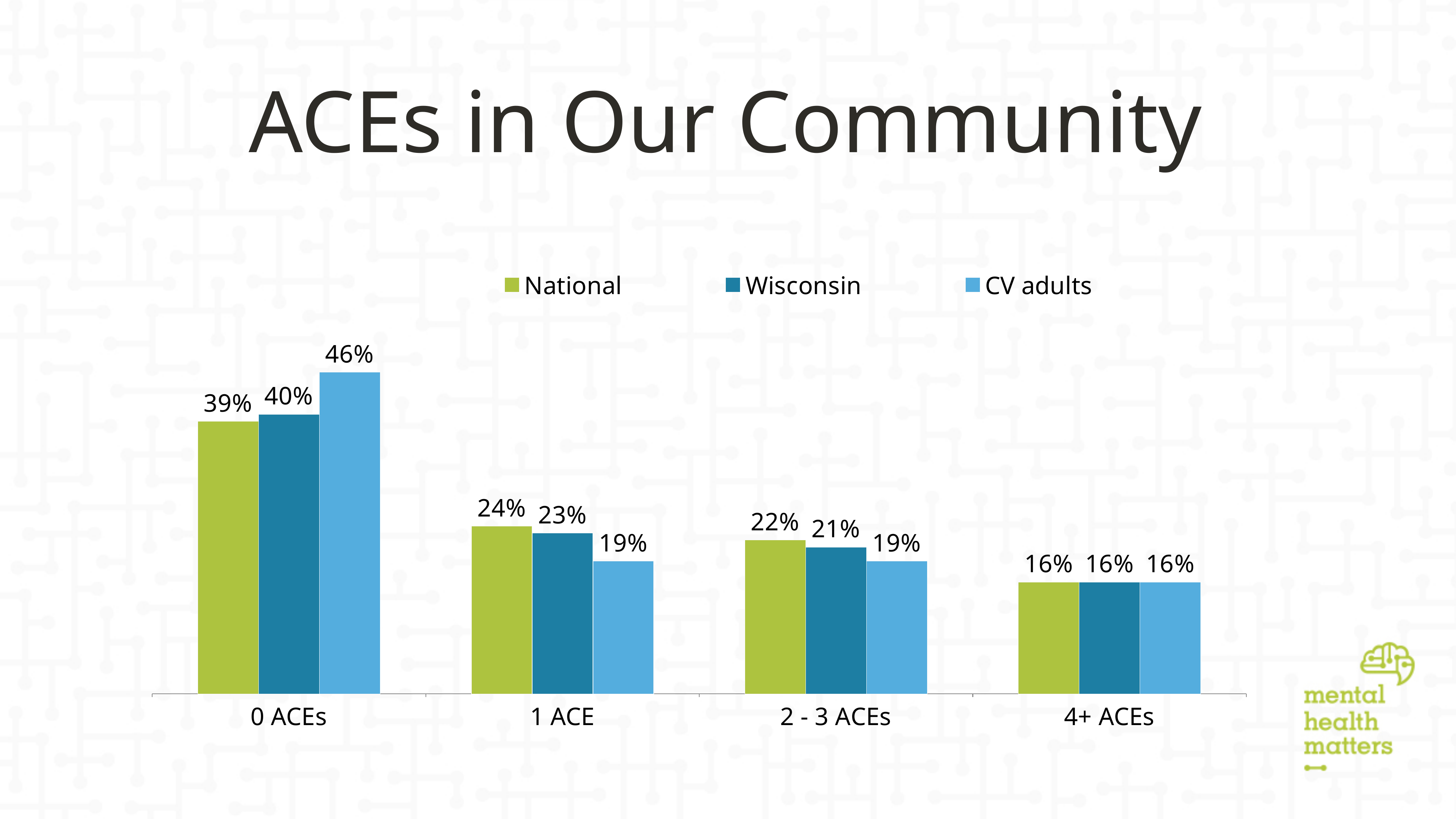
Do the National values rise or fall from 0 ACEs to 4+ ACEs? Fall What is the National value for 1 ACE? 24% How many series does the legend list? 3 What is the CV adults value for 0 ACEs? 46% Which category has the highest CV adults value? 0 ACEs What is the Wisconsin value for 4+ ACEs? 16% Which category has the lowest National value? 4+ ACEs What is the difference between the CV adults and National values for 0 ACEs? 7% What kind of chart is shown on the slide? Bar chart How many categories are shown on the x axis? 4 For 1 ACE, which is larger: the National value or the CV adults value? National What is the Wisconsin value for 2 - 3 ACEs? 21%